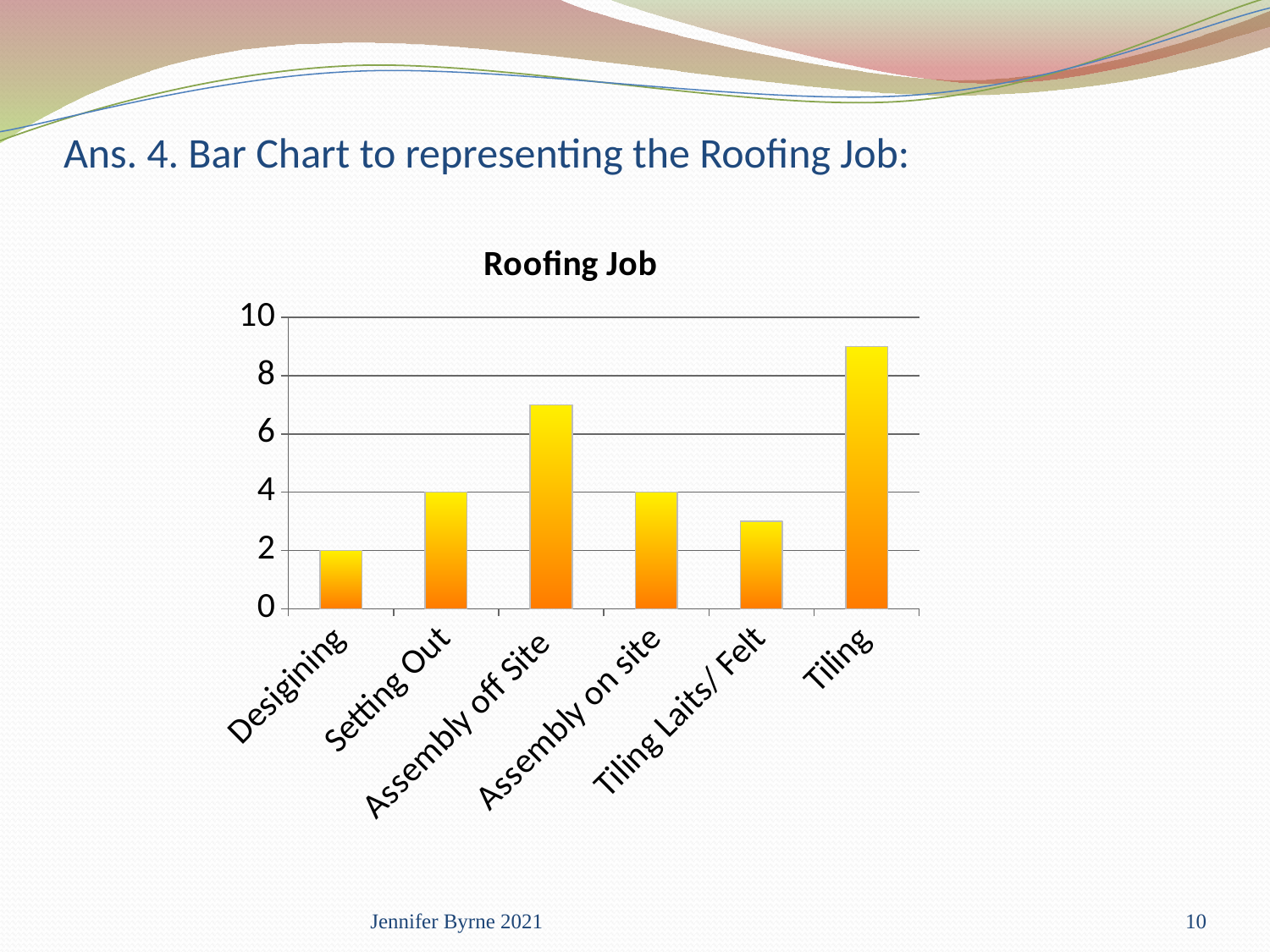
Which category has the lowest value? Desigining What is the value for Desigining? 2 What is the difference between the values for Setting Out and Desigining? 2 Which category has the highest value? Tiling What is the value for Assembly on site? 4 What is the title of the chart? Roofing Job Is the value for Tiling Laits/ Felt greater or less than 4? less What type of chart is shown on the slide? Bar chart Is the value for Assembly off Site greater or less than 6? greater Is the value for Tiling greater or less than 8? greater What is the value for Setting Out? 4 How many categories are shown on the x axis of the chart? 6